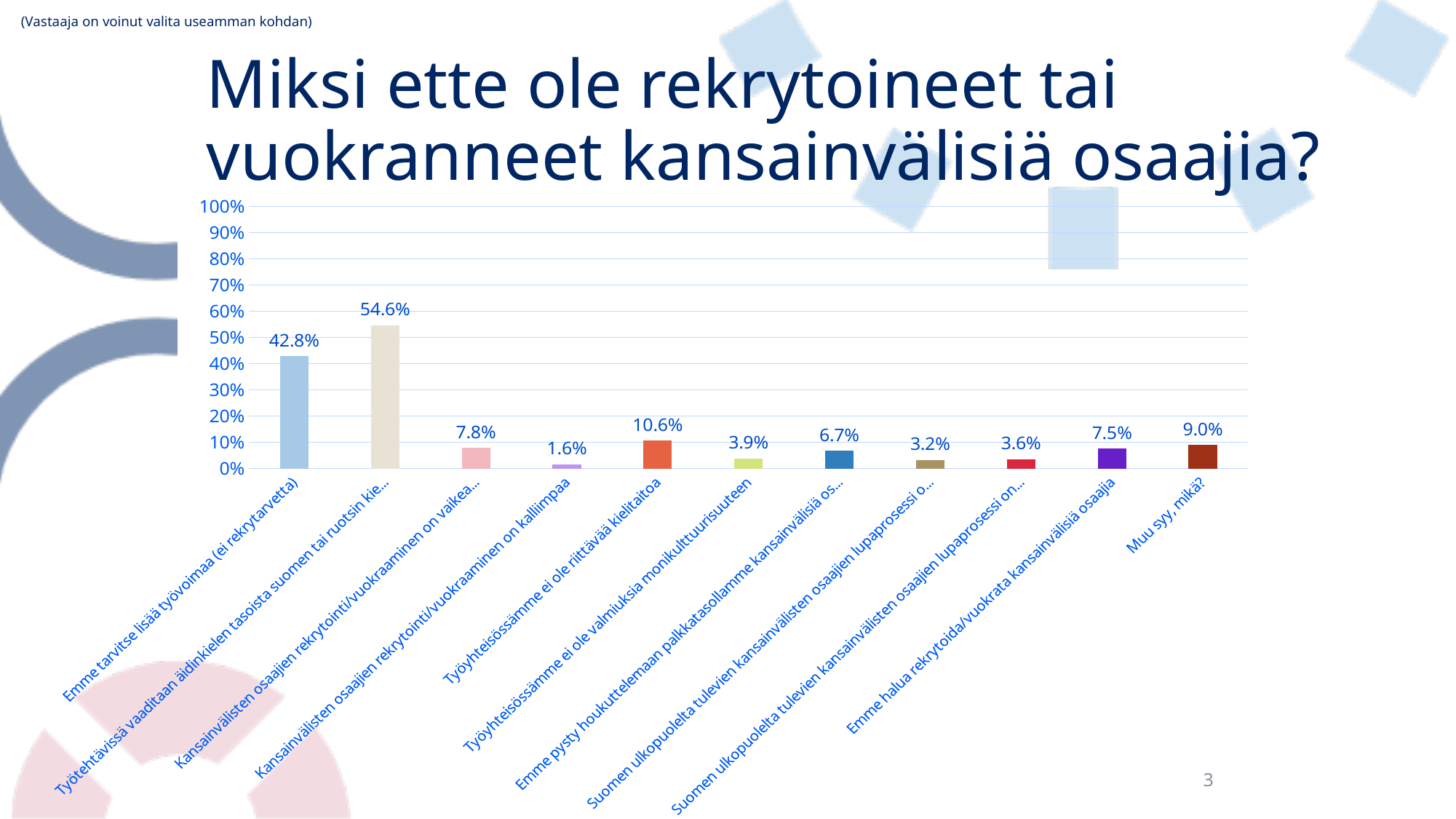
How many categories (bars) are shown in the chart? 11 Which is larger: the value for "Työyhteisössämme ei ole riittävää kielitaitoa" or the value for "Muu syy, mikä?"? Työyhteisössämme ei ole riittävää kielitaitoa Which category has the lowest value? Kansainvälisten osaajien rekrytointi/vuokraaminen on kalliimpaa Is the value for "Emme tarvitse lisää työvoimaa (ei rekrytarvetta)" greater or less than 50%? less What is the value for "Muu syy, mikä?"? 9.0% What is the value for "Työyhteisössämme ei ole valmiuksia monikulttuurisuuteen"? 3.9% What is the value for "Emme tarvitse lisää työvoimaa (ei rekrytarvetta)"? 42.8% What is the value for "Emme halua rekrytoida/vuokrata kansainvälisiä osaajia"? 7.5% What kind of chart is shown on the slide? bar chart What is the highest value shown in the chart? 54.6% What is the value for "Työyhteisössämme ei ole riittävää kielitaitoa"? 10.6% What is the difference between the two largest values, 54.6% and 42.8%? 11.8%